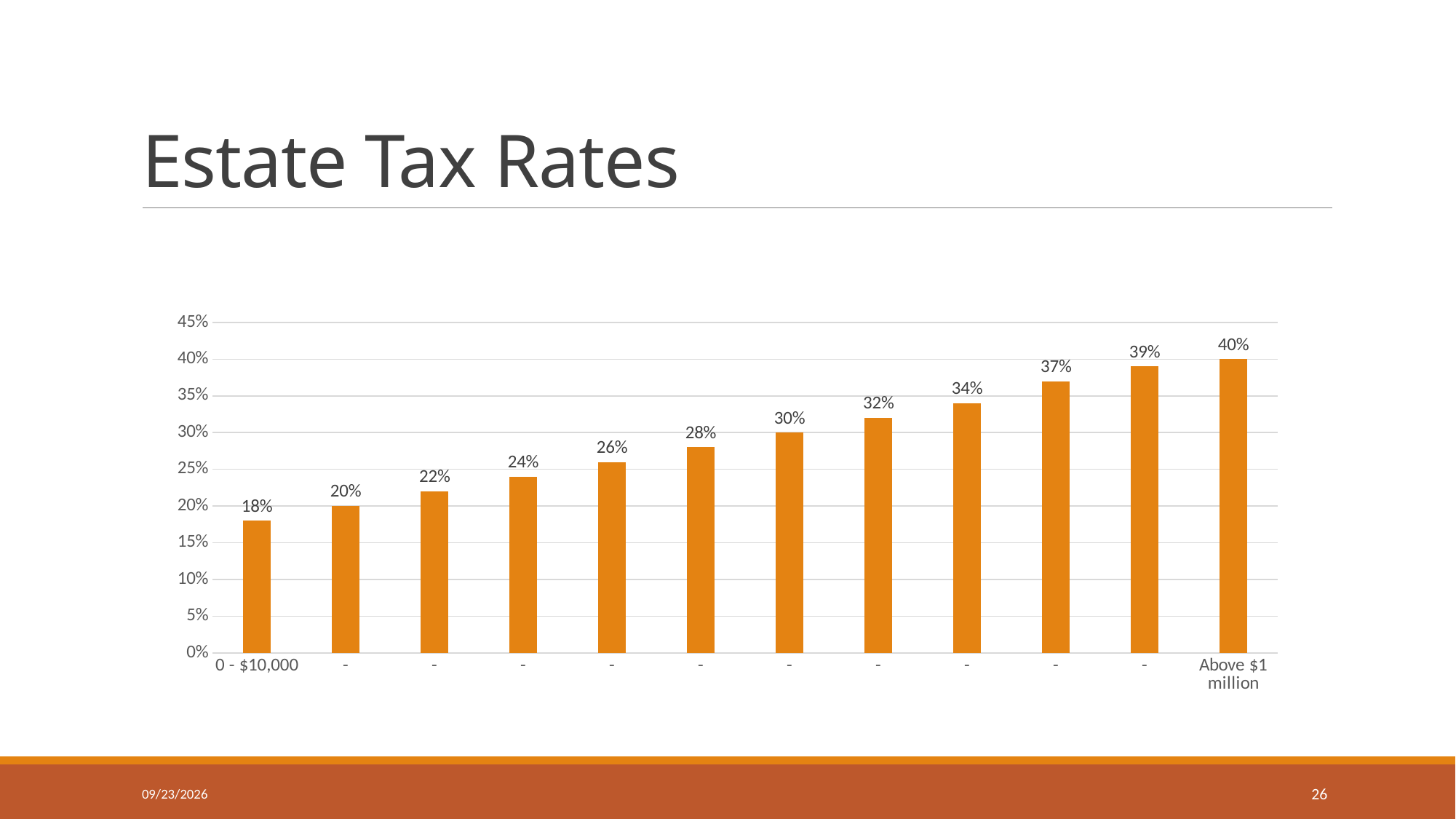
Which is larger, the rate for "0 - $10,000" or the rate for "Above $1 million"? Above $1 million Do the estate tax rates rise or fall from left to right across the chart? Rise What is the estate tax rate shown for the "0 - $10,000" category? 18% What kind of chart is shown on the slide? Bar chart What is the title of the slide containing the chart? Estate Tax Rates What is the highest value shown on the vertical axis? 45% How many bars are plotted in the chart? 12 Which category has the lowest estate tax rate? 0 - $10,000 Is the value for "0 - $10,000" greater or less than 20%? less Which category has the highest estate tax rate? Above $1 million What is the estate tax rate shown for the "Above $1 million" category? 40% What is the difference between the rate for "Above $1 million" and the rate for "0 - $10,000"? 22%